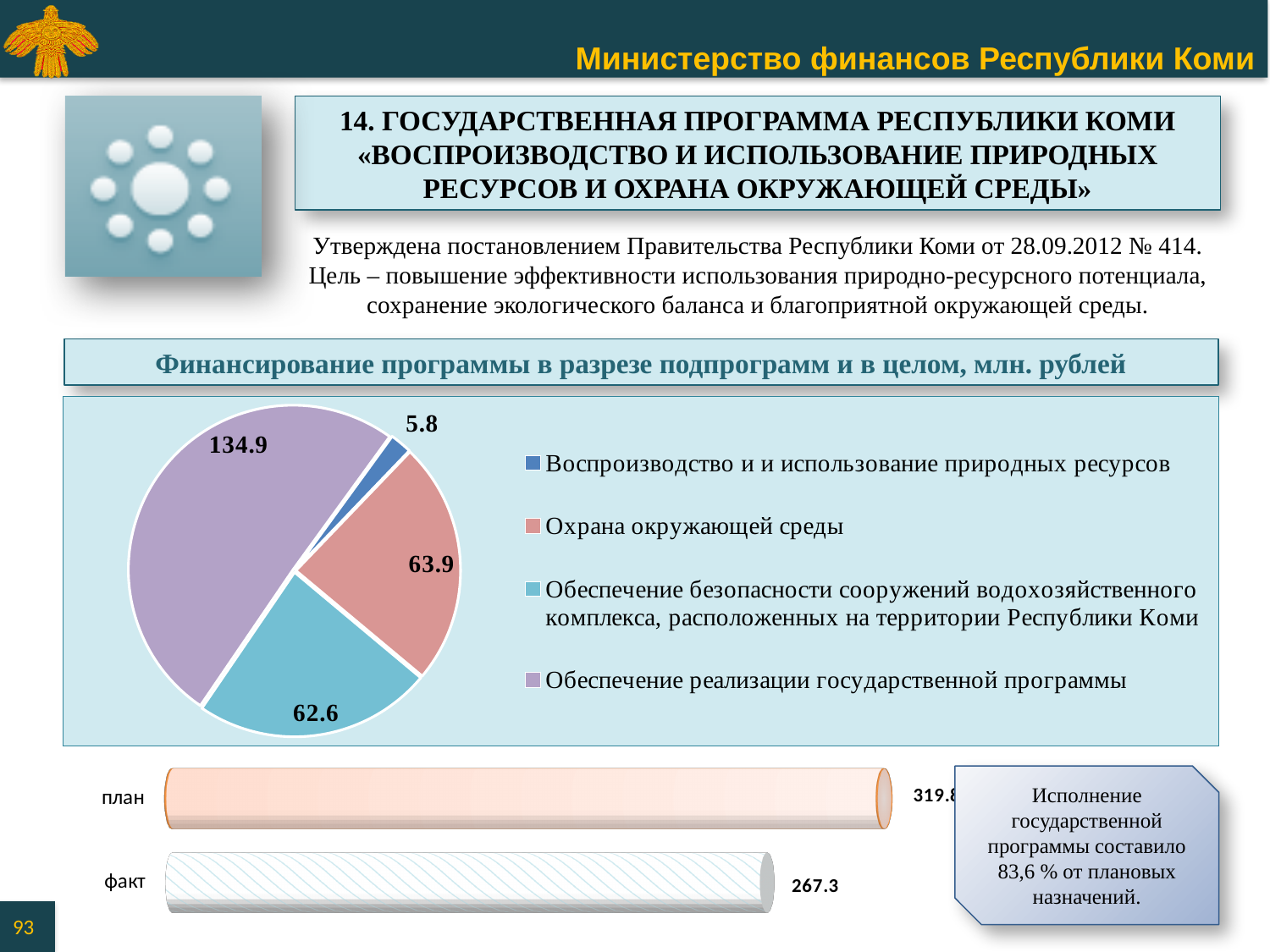
In the pie chart, what is the value for «Воспроизводство и использование природных ресурсов»? 5.8 In the pie chart, which subprogram has the smallest slice? Воспроизводство и использование природных ресурсов In the bar chart at the bottom of the slide, what is the value for «факт»? 267.3 In the pie chart, which subprogram has the largest slice? Обеспечение реализации государственной программы In the pie chart, what is the difference between the values for «Обеспечение реализации государственной программы» and «Охрана окружающей среды»? 71.0 In the pie chart, what is the value for «Обеспечение реализации государственной программы»? 134.9 In the pie chart, which is larger: the value for «Охрана окружающей среды» or for «Обеспечение безопасности сооружений водохозяйственного комплекса»? Охрана окружающей среды In the pie chart, what is the value for «Обеспечение безопасности сооружений водохозяйственного комплекса, расположенных на территории Республики Коми»? 62.6 In the pie chart, how many slices (subprograms) are shown? 4 In the bar chart at the bottom of the slide, which bar is longer: «план» or «факт»? план In the pie chart, what is the value for «Охрана окружающей среды»? 63.9 What kind of chart is shown in the upper chart area under the heading «Финансирование программы в разрезе подпрограмм и в целом, млн. рублей»? pie chart